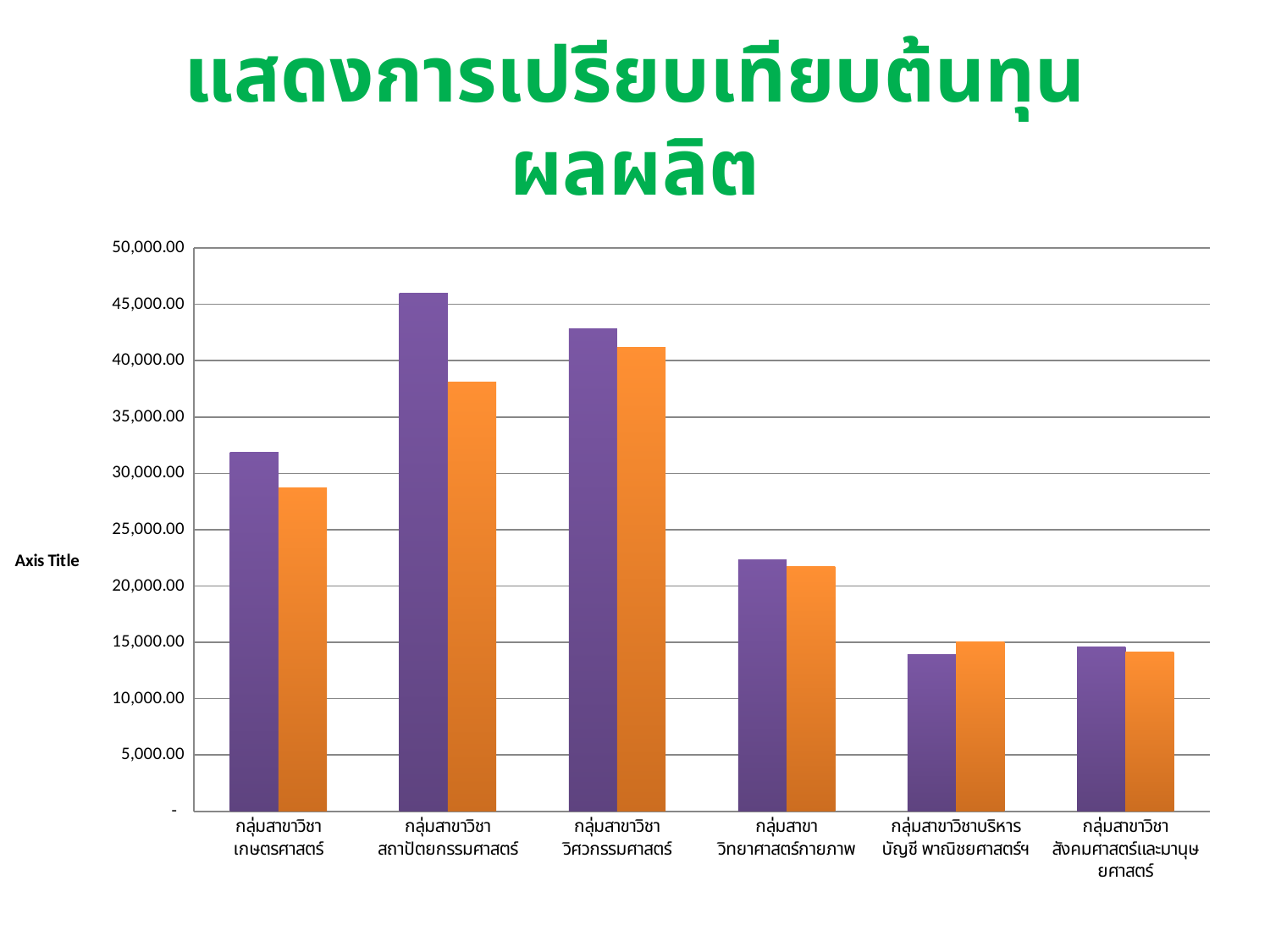
For กลุ่มสาขาวิชาบริหารบัญชี พาณิชยศาสตร์ฯ, which bar is larger, the purple one or the orange one? orange Which category has the highest purple bar? กลุ่มสาขาวิชาสถาปัตยกรรมศาสตร์ Which category has the highest orange bar? กลุ่มสาขาวิชาวิศวกรรมศาสตร์ What is the title of the chart slide? แสดงการเปรียบเทียบต้นทุนผลผลิต Is the orange bar for กลุ่มสาขาวิชาสถาปัตยกรรมศาสตร์ greater or less than 40,000.00? less How many categories are shown on the x axis of the chart? 6 What is the label shown on the vertical axis? Axis Title For กลุ่มสาขาวิชาเกษตรศาสตร์, which bar is larger, the purple one or the orange one? purple Is the orange bar for กลุ่มสาขาวิชาเกษตรศาสตร์ greater or less than 30,000.00? less Is the purple bar for กลุ่มสาขาวิชาสถาปัตยกรรมศาสตร์ greater or less than 45,000.00? greater What kind of chart is shown on the slide? bar chart